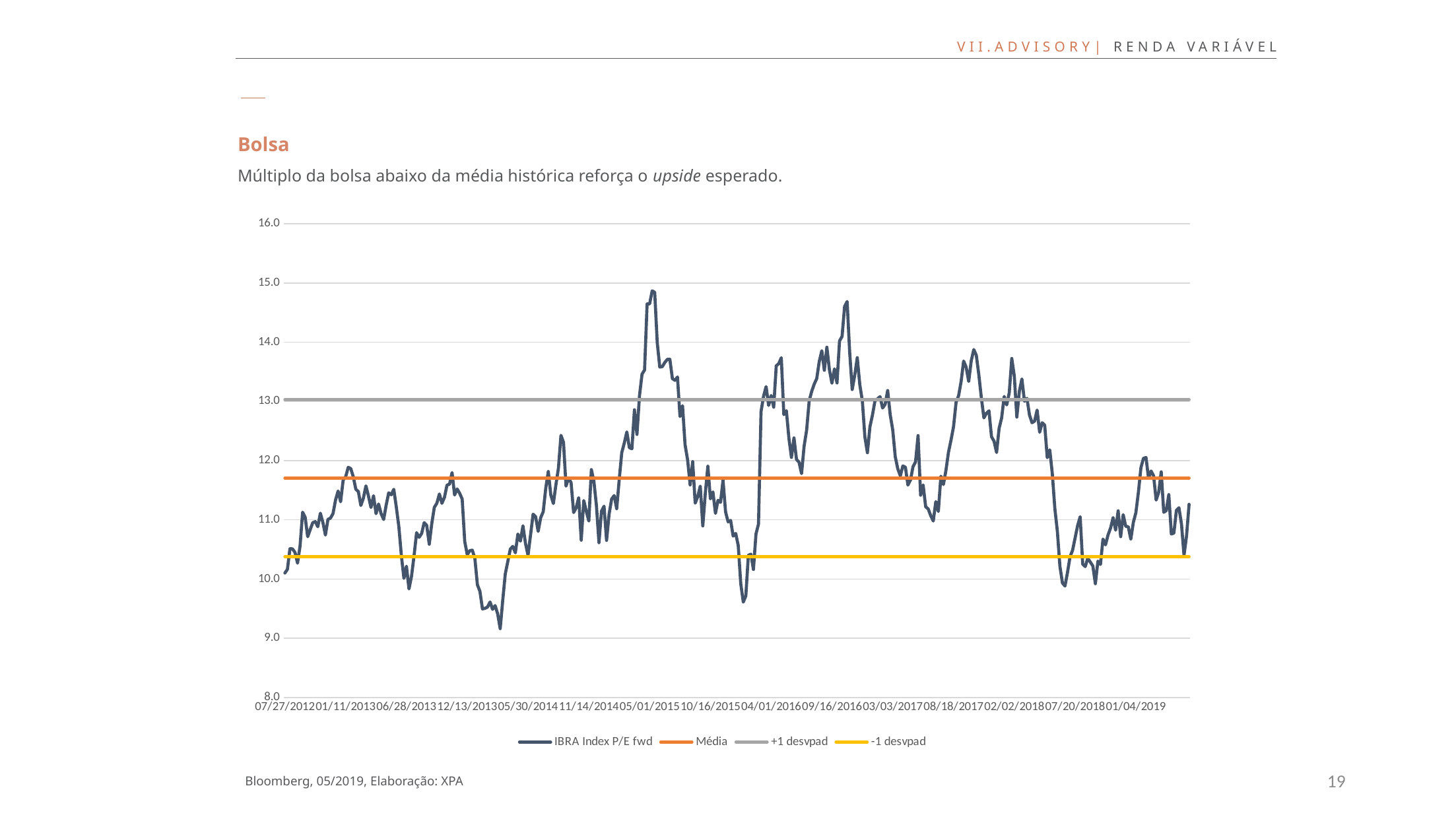
At the right end of the chart, is the IBRA Index P/E fwd line above or below the Média line? below Is the Média line greater or less than 11.0? greater Is the highest peak of the IBRA Index P/E fwd line greater or less than 14.0? greater Is the -1 desvpad line greater or less than 11.0? less How many series does the legend list? 4 Which series is drawn as the orange horizontal line? Média What kind of chart is shown on the slide? line chart Which series is drawn as the yellow horizontal line? -1 desvpad Of the three horizontal reference lines, which one is the highest? +1 desvpad